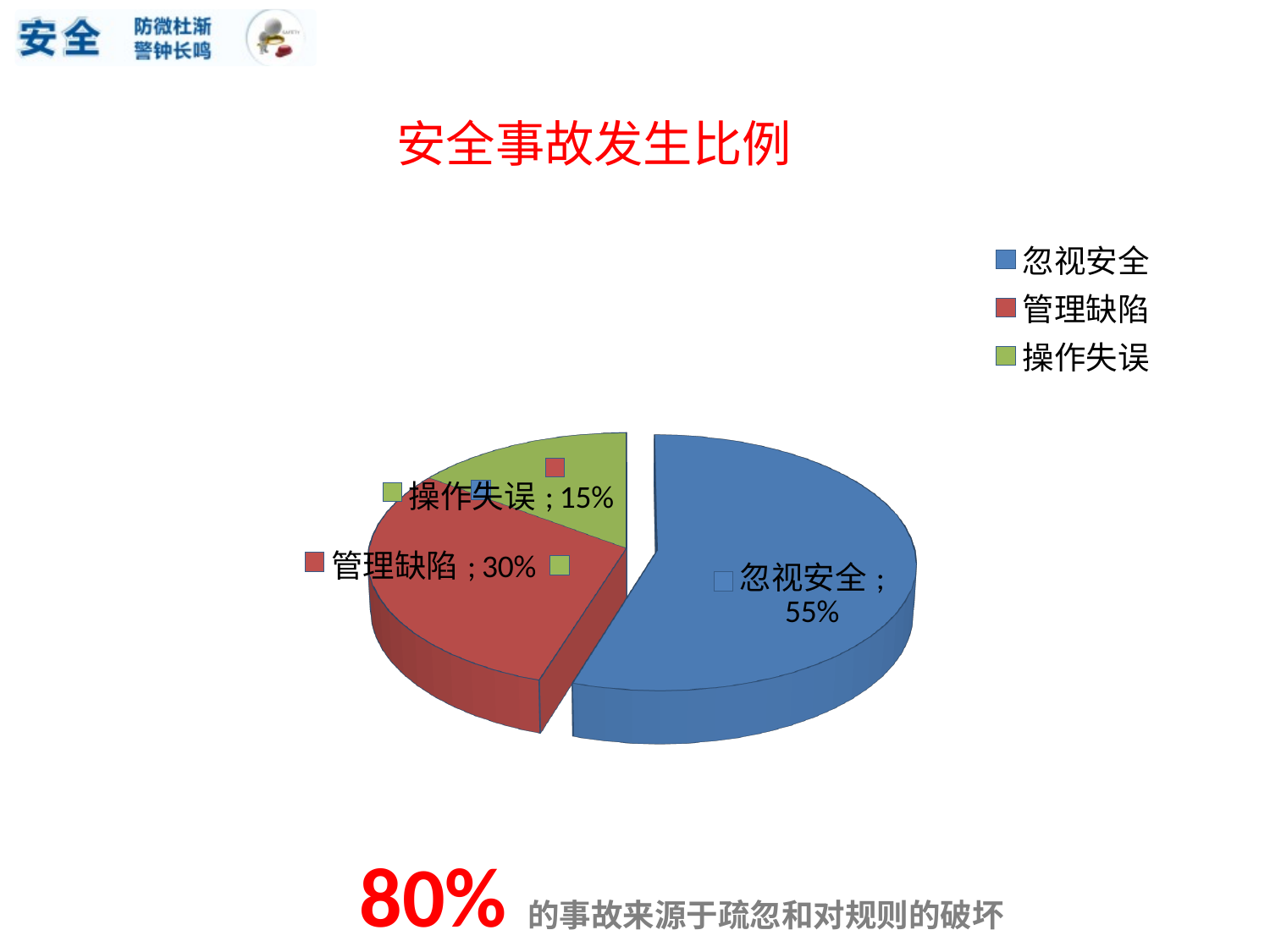
What is the difference between the values for 管理缺陷 and 操作失误? 15% Which category has the largest share of the pie? 忽视安全 Which colour represents 管理缺陷 in the legend? red Which category has the smallest share of the pie? 操作失误 What is the difference between the values for 忽视安全 and 管理缺陷? 25% What type of chart is shown on the slide? pie chart What is the title of the chart? 安全事故发生比例 How many categories does the pie chart have? 3 What is the value for 忽视安全? 55% What is the value for 管理缺陷? 30% What is the value for 操作失误? 15% Which is larger, the value for 管理缺陷 or the value for 操作失误? 管理缺陷